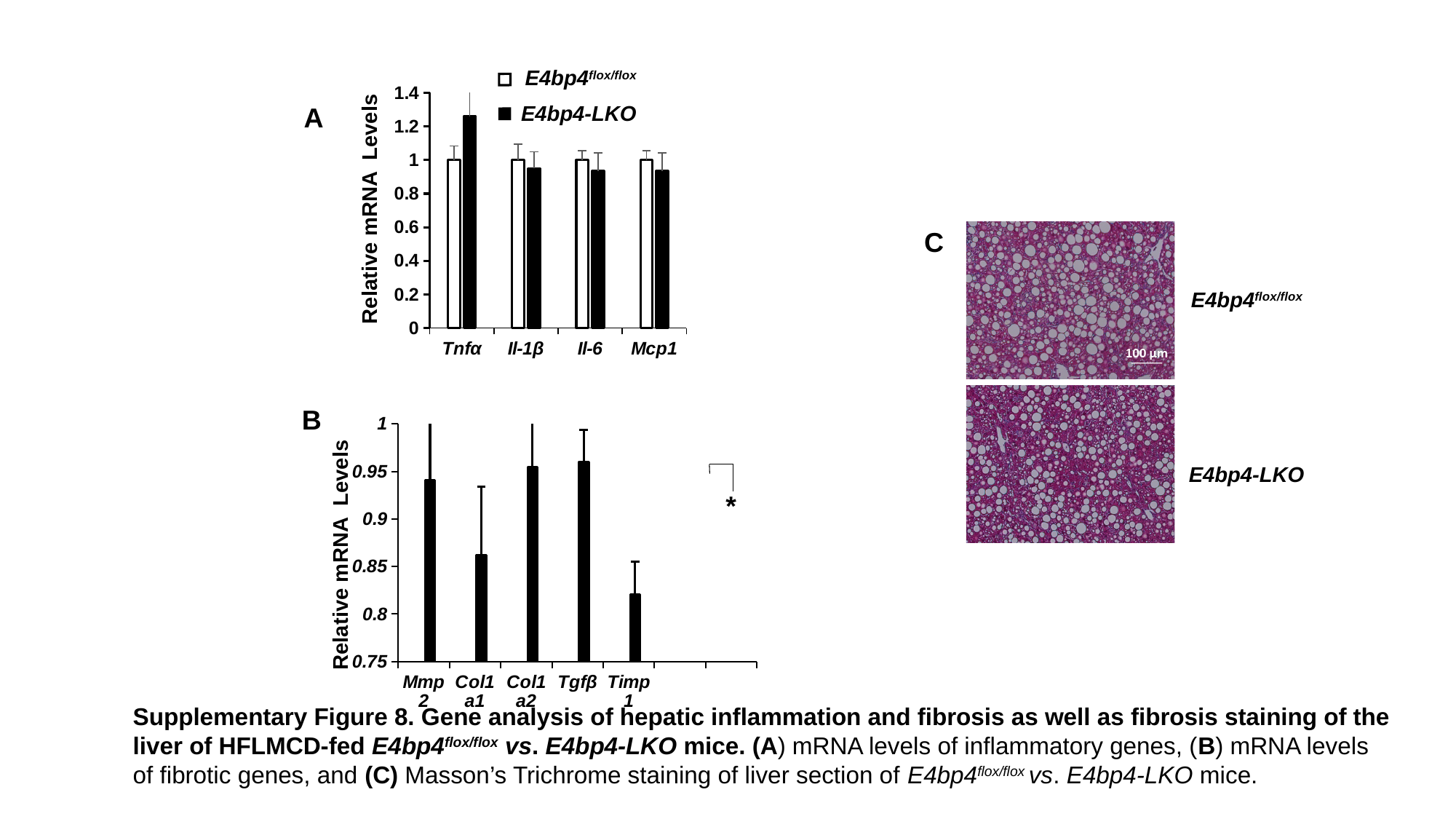
In panel B, is the value for Timp1 greater or less than 0.85? less In panel A, how many series does the legend list? 2 In panel B, how many genes are shown on the x axis? 5 In panel B, which has the larger value, Mmp2 or Col1a1? Mmp2 In panel B, which gene has the lowest relative mRNA level? Timp1 In panel A, for Tnfα, which series has the larger value, E4bp4flox/flox or E4bp4-LKO? E4bp4-LKO In panel A, which gene has the highest E4bp4-LKO value? Tnfα In panel A, how many genes are shown on the x axis? 4 In panel A, is the E4bp4-LKO value for Il-6 greater or less than 0.8? greater In panel A, is the E4bp4-LKO value for Tnfα greater or less than 1.2? greater In panel A, what is the E4bp4flox/flox value for Tnfα? 1 In panel A, what kind of chart is shown? bar chart